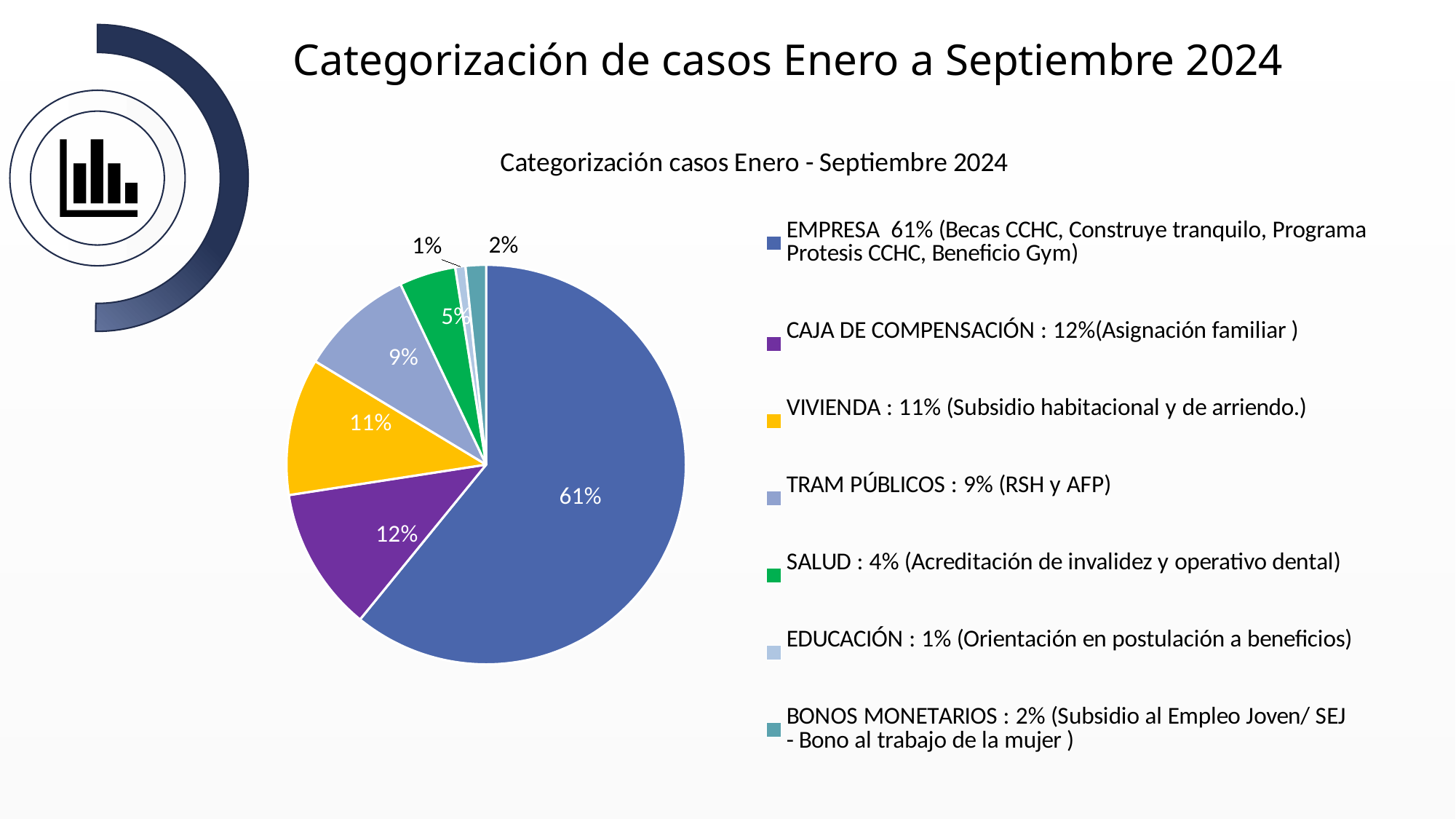
What percentage of cases does the CAJA DE COMPENSACIÓN slice represent? 12% What percentage of cases does the EMPRESA slice represent? 61% What percentage of cases does the TRAM PÚBLICOS slice represent? 9% What type of chart is shown on the slide? pie chart What percentage of cases does the EDUCACIÓN slice represent? 1% How many categories does the legend list? 7 Which slice is larger, VIVIENDA or TRAM PÚBLICOS? VIVIENDA What is the title of the chart? Categorización casos Enero - Septiembre 2024 Which category has the largest share of the pie? EMPRESA What is the difference in percentage points between the EMPRESA slice and the CAJA DE COMPENSACIÓN slice? 49% What percentage of cases does the VIVIENDA slice represent? 11% Which category has the smallest share of the pie? EDUCACIÓN